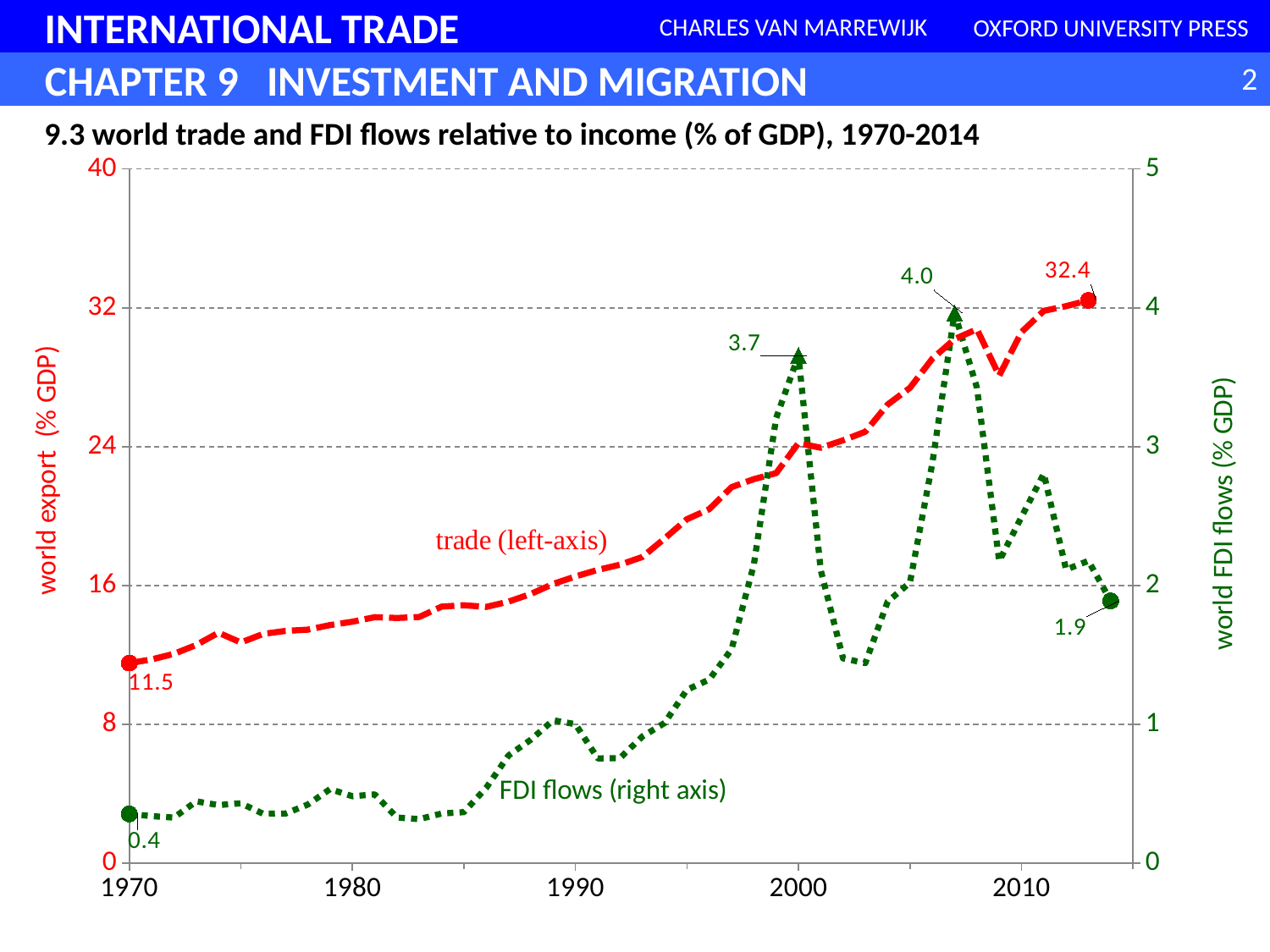
What value is labelled for FDI flows at the 2000 peak? 3.7 What is the value of world trade (% of GDP) in 1970? 11.5 What is the final labelled value of the FDI flows series? 1.9 By how much did the trade series increase from its first labelled value (11.5) to its last labelled value (32.4)? 20.9 Is the value for trade in 1980 greater or less than 16? less Does the trade series generally rise or fall from 1970 to 2014? rise What is the final labelled value of the trade series? 32.4 What type of chart is shown on the slide? line chart What is the difference between the two labelled FDI peaks, 4.0 and 3.7? 0.3 What is the value of world FDI flows (% of GDP) in 1970? 0.4 Which axis is used for the FDI flows series? right axis What is the highest labelled value for FDI flows? 4.0